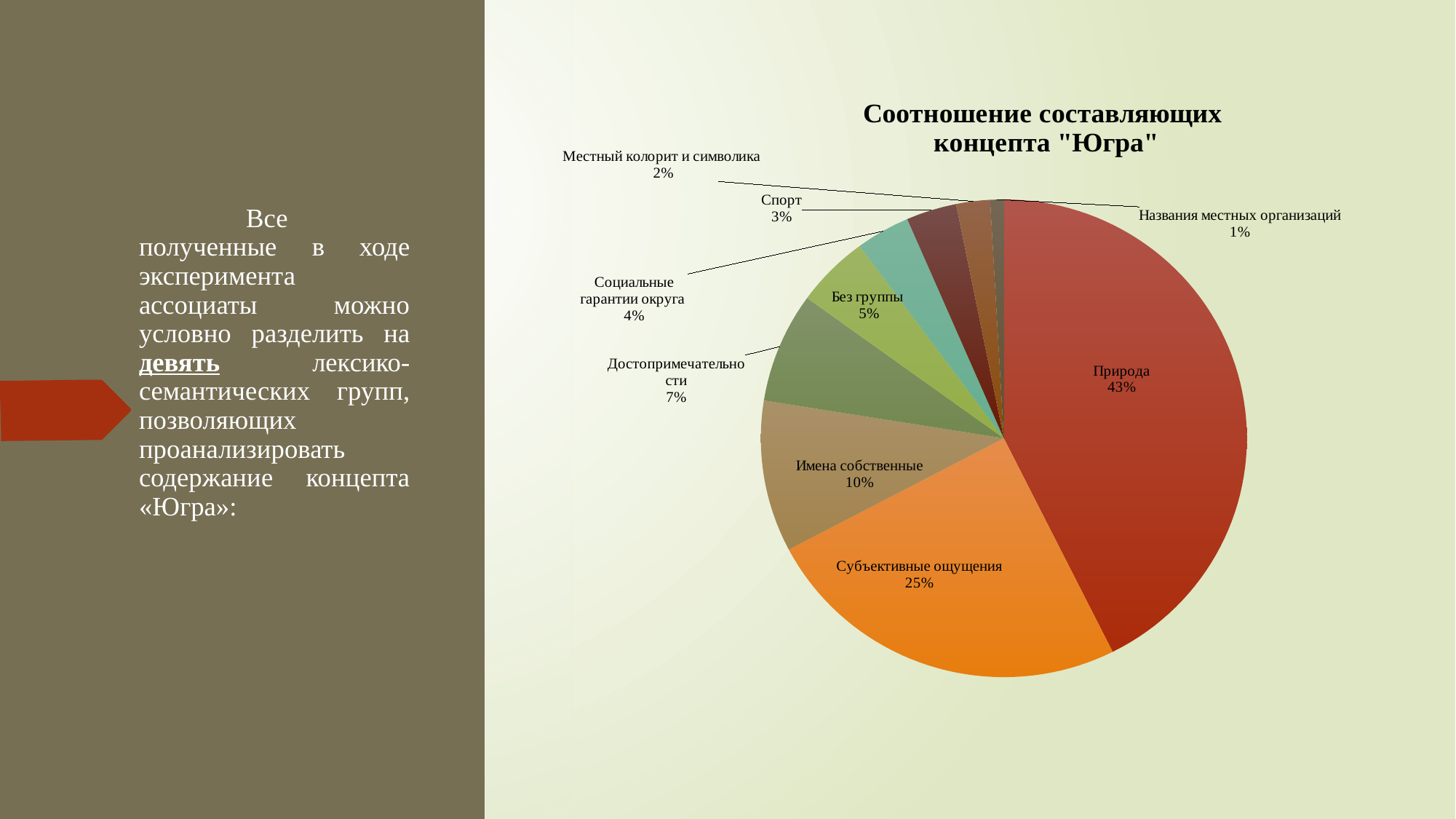
What is the difference between the values for Природа and Субъективные ощущения? 18% What kind of chart is shown on the slide? pie chart What is the value for Имена собственные? 10% What share of the pie does Природа take? 43% What is the value for Социальные гарантии округа? 4% Which category has the smallest slice of the pie? Названия местных организаций What is the value for Субъективные ощущения? 25% Which is larger, the value for Без группы or the value for Спорт? Без группы Which category has the largest slice of the pie? Природа What is the value for Достопримечательности? 7% How many categories are shown in the pie chart? 9 What is the title of the chart? Соотношение составляющих концепта "Югра"